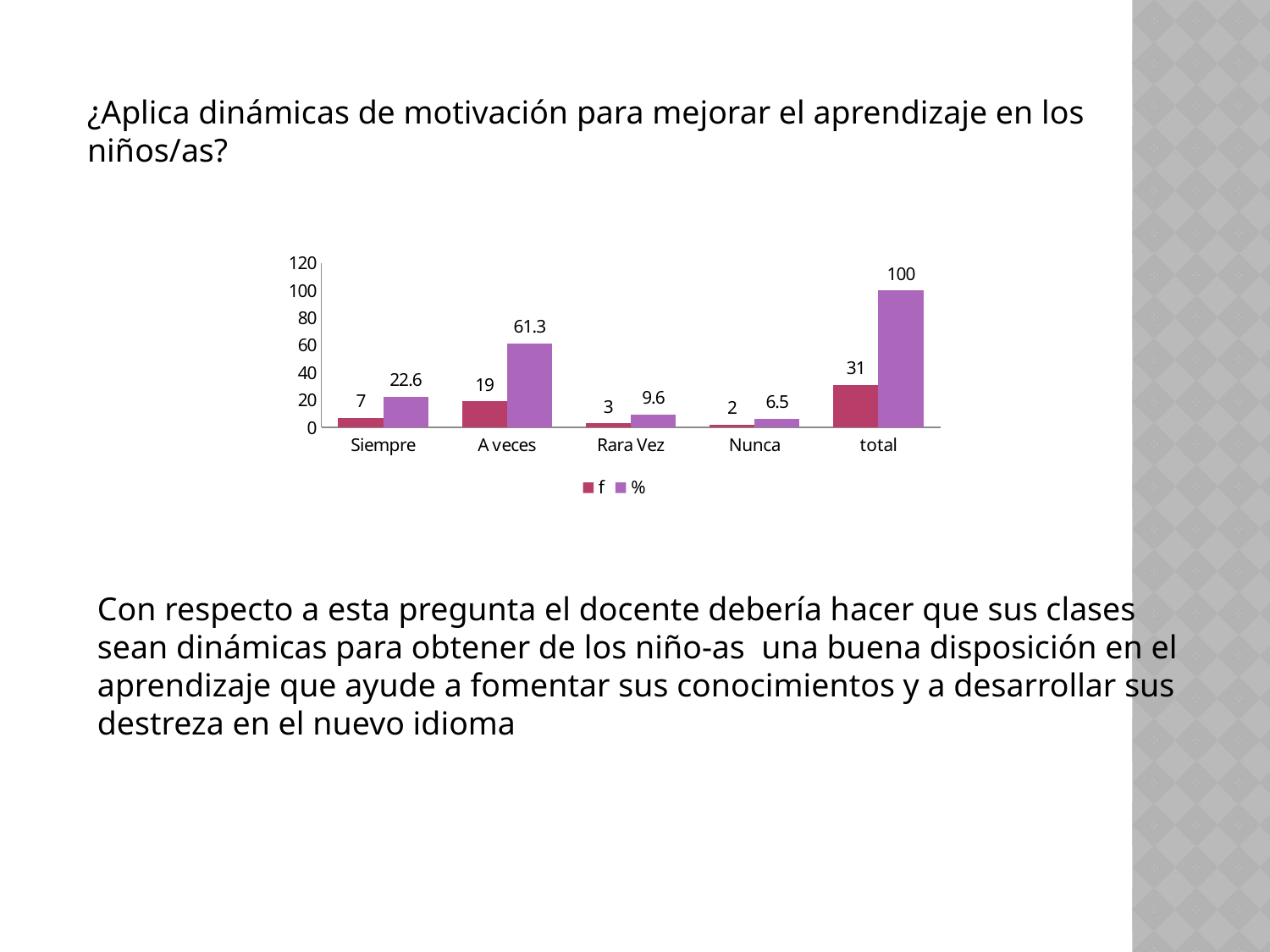
Which category has the lowest f value? Nunca What is the value of the % series for Rara Vez? 9.6 Which is larger, the f value for Siempre or the f value for Rara Vez? Siempre What is the value of the f series for A veces? 19 What is the value of the f series for Nunca? 2 How many series does the legend list? 2 What kind of chart is shown on the slide? Bar chart What is the value of the % series for Siempre? 22.6 How many categories are shown on the x axis? 5 What are the two series names listed in the legend? f and % Excluding the total category, which category has the highest % value? A veces What is the difference between the % values for A veces and Siempre? 38.7